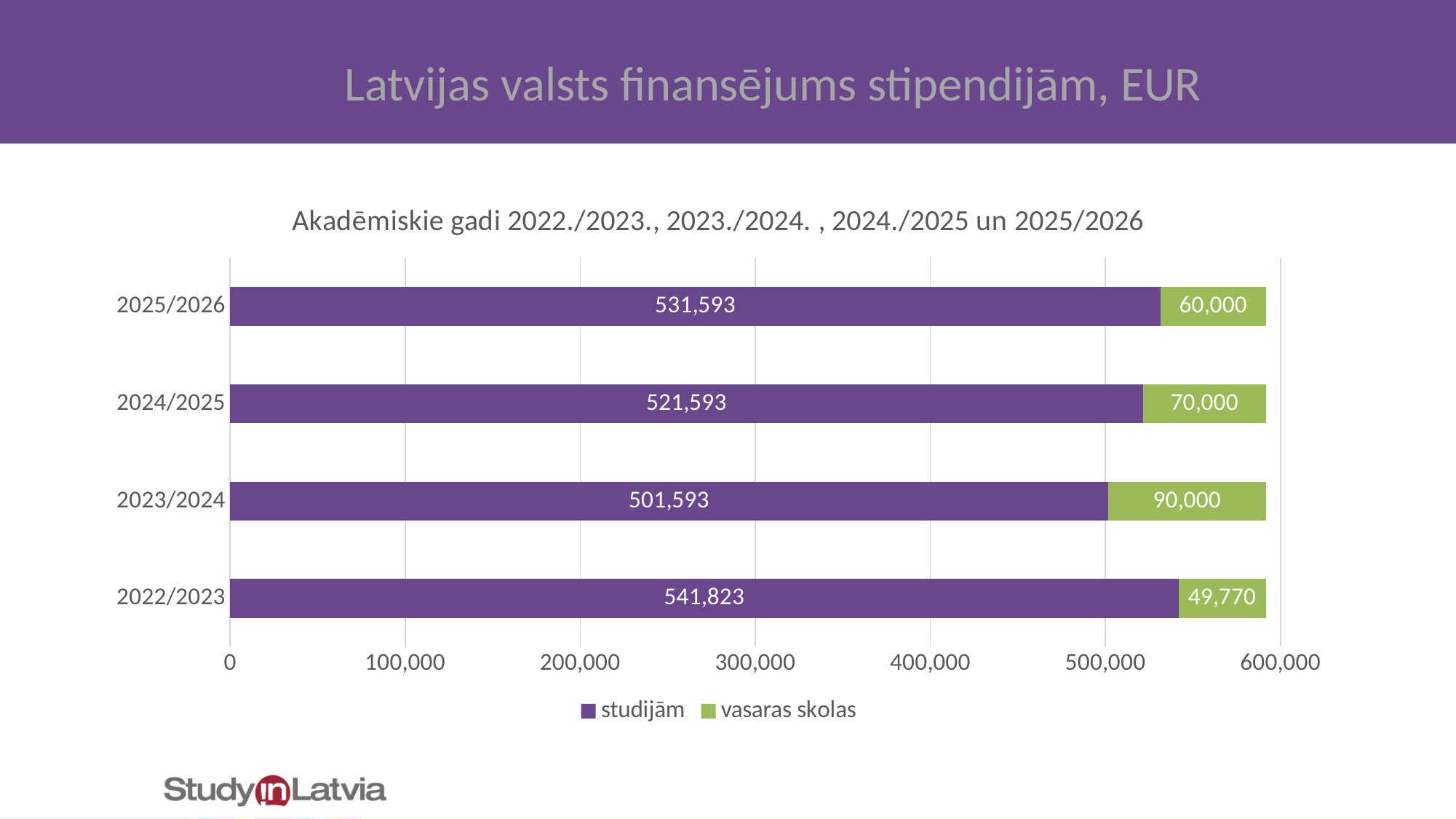
Which academic year has the highest value for studijām? 2022/2023 What is the value for studijām in 2025/2026? 531,593 What is the total of the stacked bar for 2024/2025? 591,593 How many series does the legend list? 2 Is the studijām value for 2023/2024 greater or less than 500,000? greater Which is larger: the studijām value for 2024/2025 or for 2025/2026? 2025/2026 What is the difference between the vasaras skolas values for 2023/2024 and 2024/2025? 20,000 What is the value for studijām in 2022/2023? 541,823 What is the value for vasaras skolas in 2023/2024? 90,000 Which academic year has the lowest value for vasaras skolas? 2022/2023 What kind of chart is shown on the slide? Stacked bar chart How many academic years are shown on the chart? 4